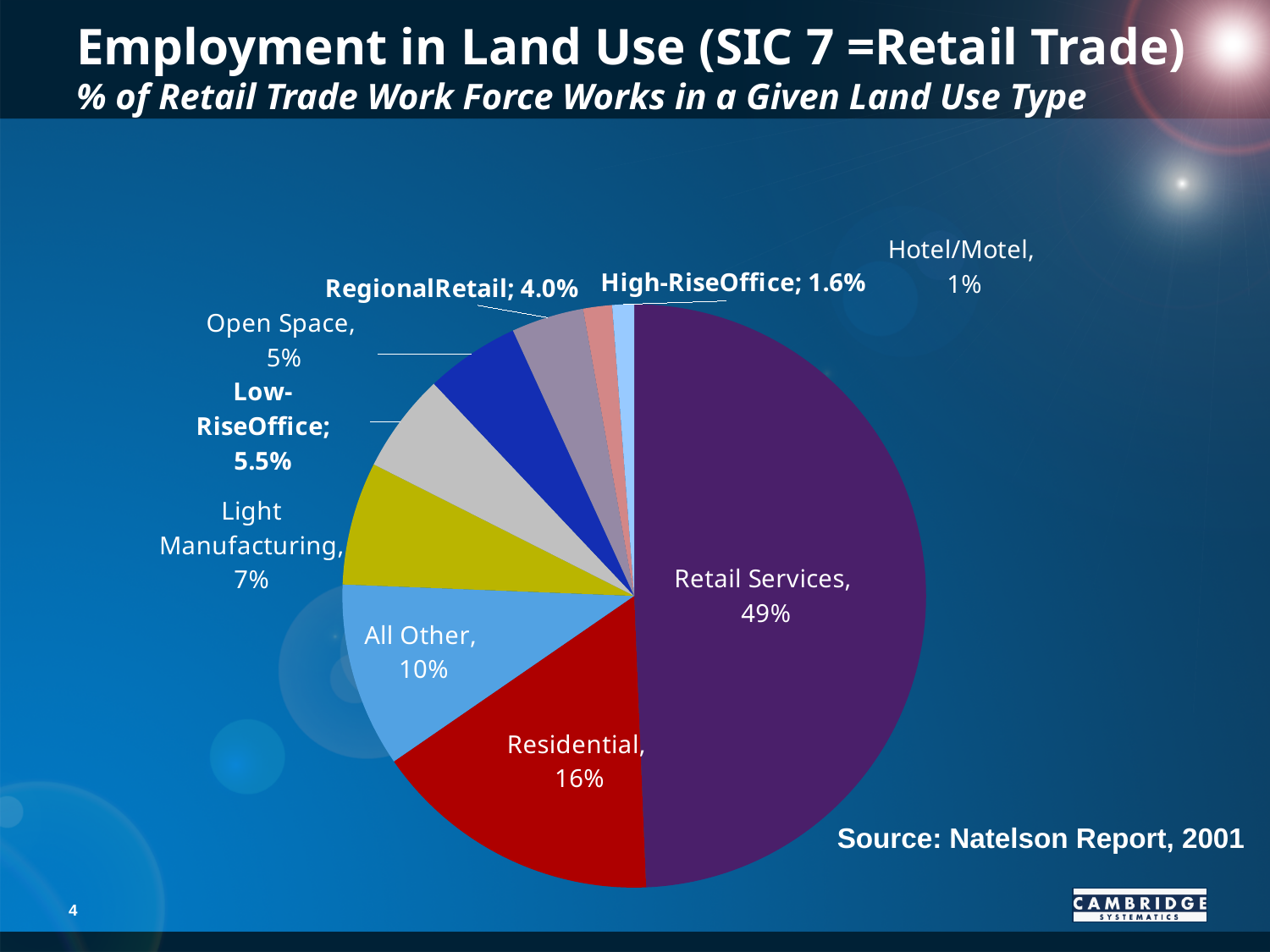
What share of the retail trade work force works in Retail Services? 49% What kind of chart is shown on the slide? Pie chart What percentage is shown for Residential? 16% Which land use type has the smallest share of the pie? Hotel/Motel What is the combined share of Open Space and RegionalRetail? 9.0% What is the difference in percentage points between Retail Services and Residential? 33 What source is cited for the chart data? Natelson Report, 2001 How many slices does the pie chart have? 9 What percentage is shown for High-RiseOffice? 1.6% What value is labelled for Low-RiseOffice? 5.5% Which land use type has the largest share of the pie? Retail Services Which is larger, the share for All Other or the share for Light Manufacturing? All Other